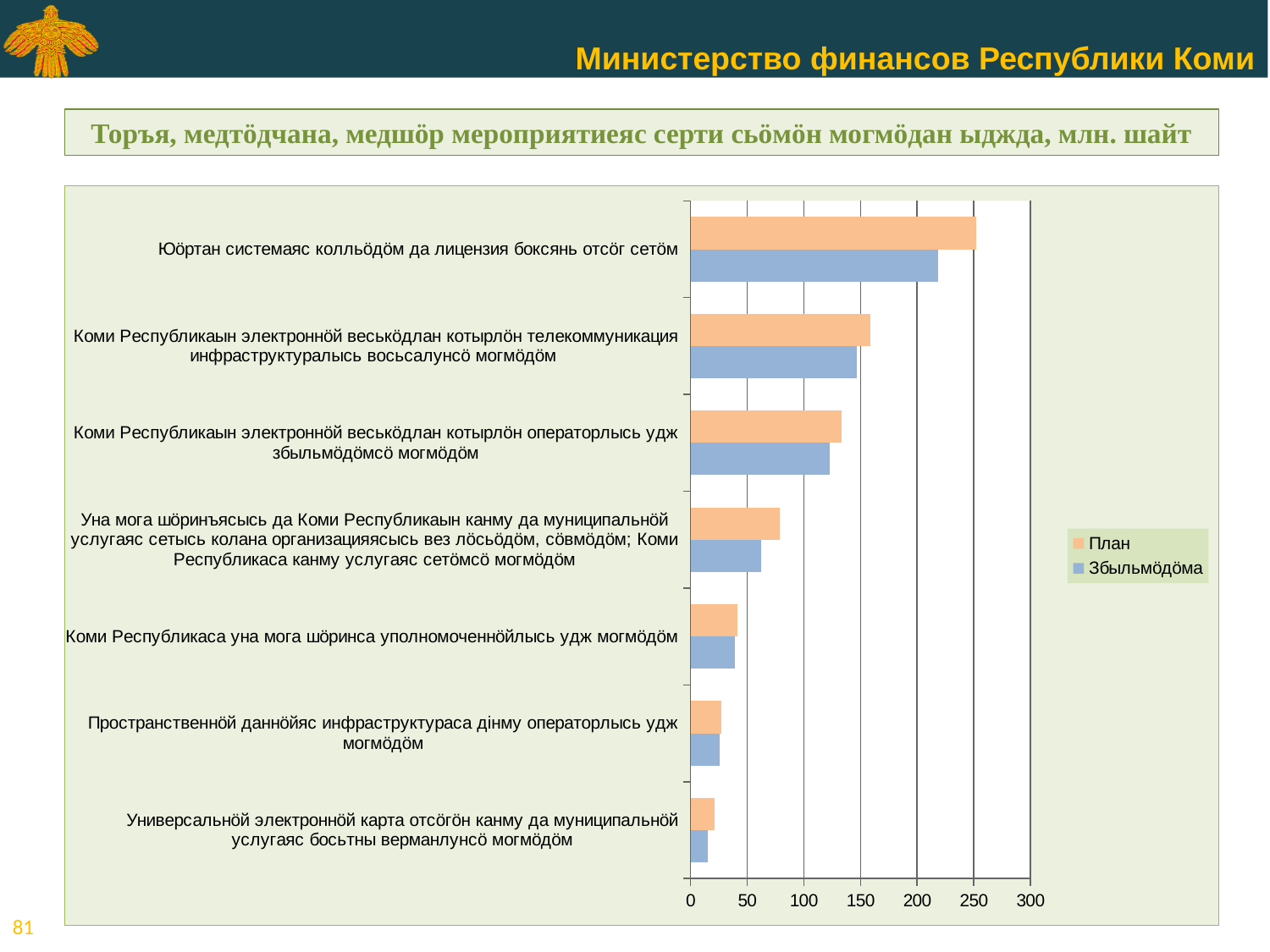
What kind of chart is shown on the slide? bar chart How many categories are plotted on the chart? 7 Is the План value for 'Уна мога шӧринъясысь да Коми Республикаын канму да муниципальнӧй услугаяс сетысь колана организацияясысь вез лӧсьӧдӧм, сӧвмӧдӧм; Коми Республикаса канму услугаяс сетӧмсӧ могмӧдӧм' greater or less than 100? less Is the Збыльмӧдӧма value for 'Коми Республикаса уна мога шӧринса уполномоченнӧйлысь удж могмӧдӧм' greater or less than 50? less Which category has the highest План value? Юӧртан системаяс колльӧдӧм да лицензия боксянь отсӧг сетӧм For 'Юӧртан системаяс колльӧдӧм да лицензия боксянь отсӧг сетӧм', which is larger: План or Збыльмӧдӧма? План Is the Збыльмӧдӧма value for 'Коми Республикаын электроннӧй веськӧдлан котырлӧн телекоммуникация инфраструктуралысь восьсалунсӧ могмӧдӧм' greater or less than 100? greater How many series does the legend list? 2 What unit is given in the chart title? млн. шайт Which category has the lowest Збыльмӧдӧма value? Универсальнӧй электроннӧй карта отсӧгӧн канму да муниципальнӧй услугаяс босьтны верманлунсӧ могмӧдӧм Which series is shown in orange in the legend? План